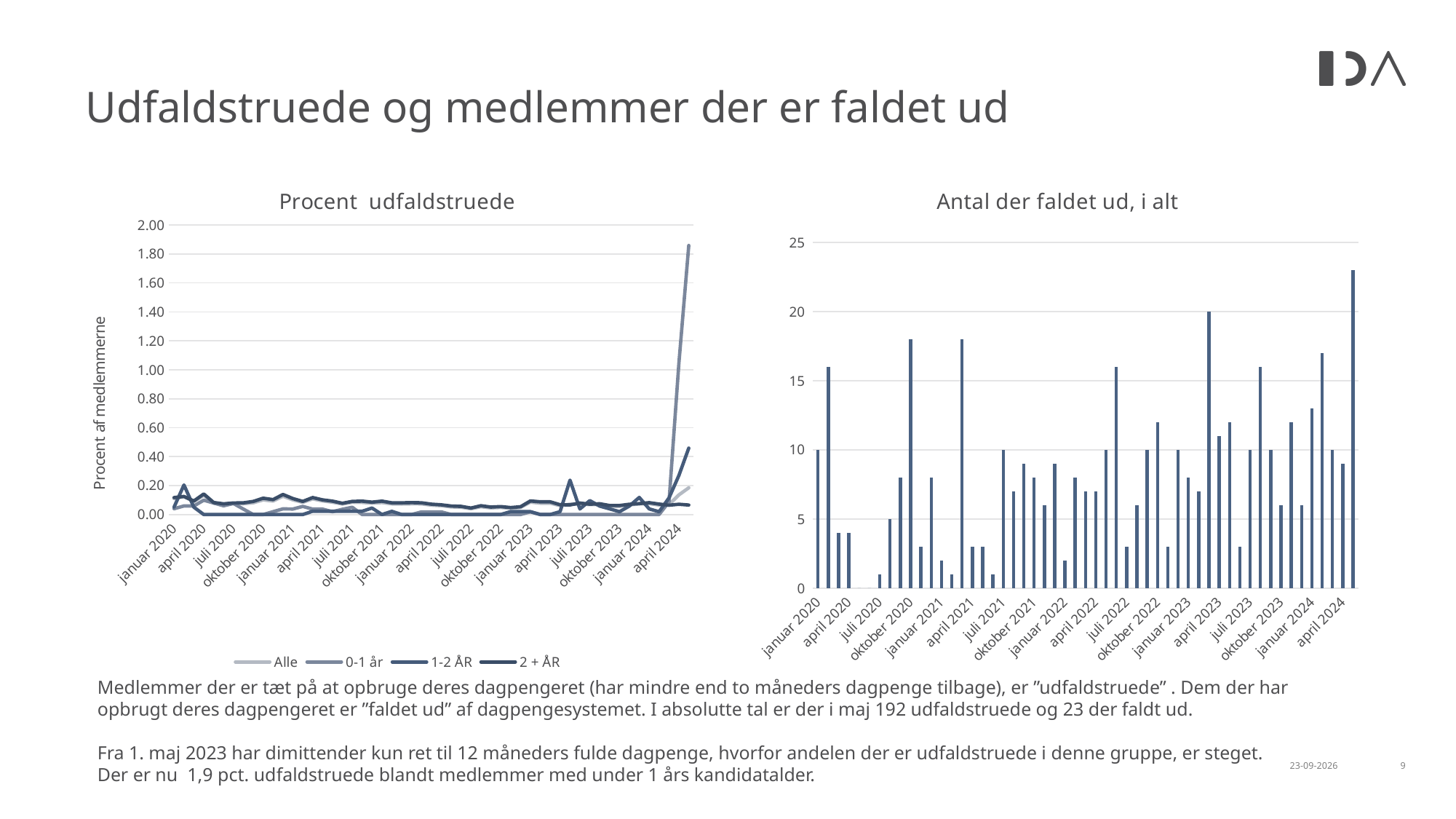
In the right chart "Antal der faldet ud, i alt", is the value for oktober 2020 greater or less than 15? greater In the left chart "Procent udfaldstruede", what is the label on the vertical axis? Procent af medlemmerne In the right chart "Antal der faldet ud, i alt", is the value for januar 2020 greater or less than 5? greater In the right chart "Antal der faldet ud, i alt", is the value for april 2023 greater or less than 15? less What kind of chart is the right chart titled "Antal der faldet ud, i alt"? bar chart What kind of chart is the left chart titled "Procent udfaldstruede"? line chart In the left chart "Procent udfaldstruede", how many series does the legend list? 4 In the right chart "Antal der faldet ud, i alt", which is larger, the value for april 2021 or the value for juli 2021? juli 2021 In the left chart "Procent udfaldstruede", which series rises sharply at the right end of the x axis? 0-1 år